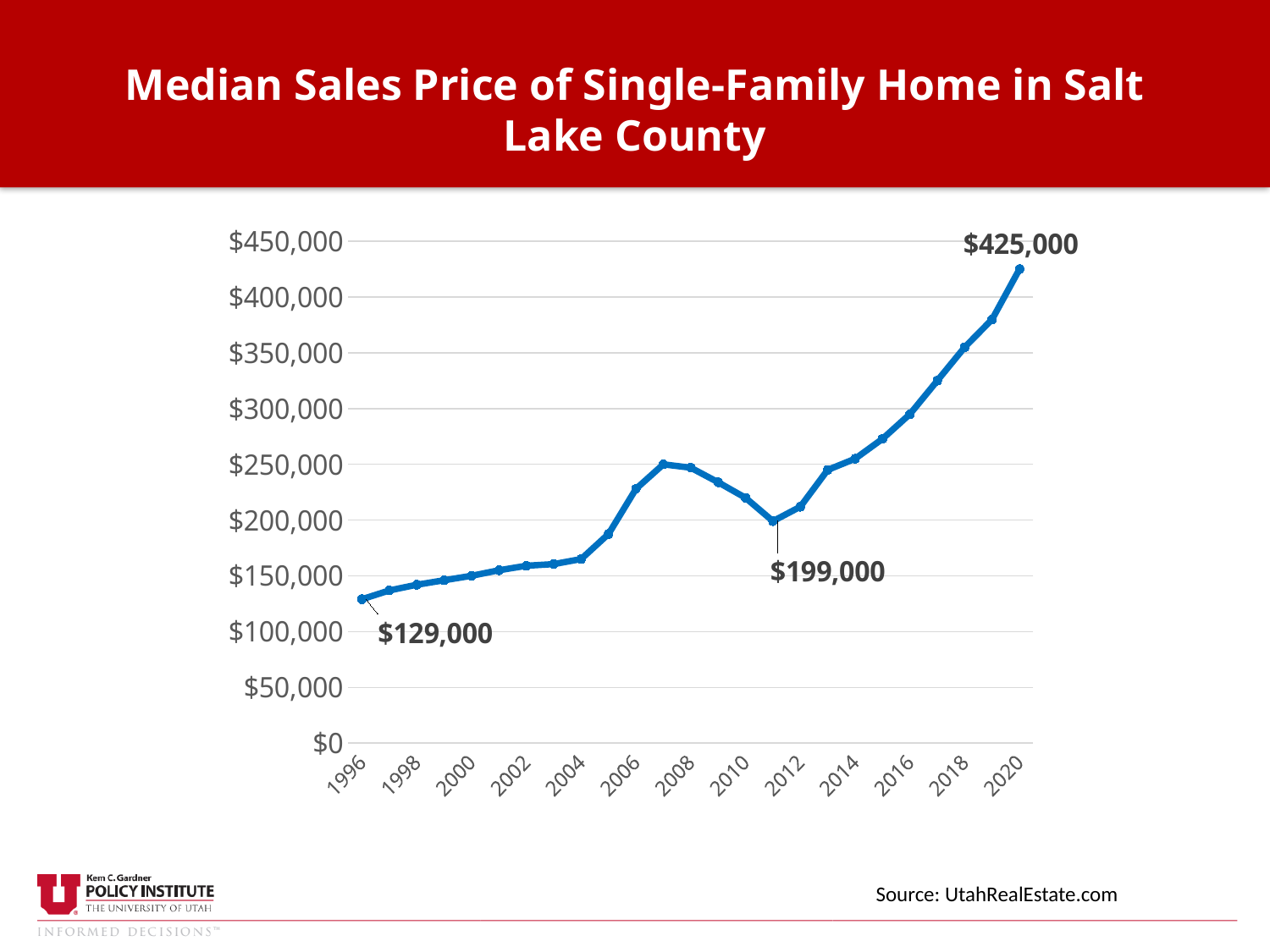
What was the median sales price of a single-family home in Salt Lake County in 1996? $129,000 What value is labeled at the low point of the dip around 2011? $199,000 Is the median sales price in 2002 greater or less than $200,000? less Which year has the highest median sales price on the chart? 2020 What is the difference between the $425,000 label and the $199,000 label? $226,000 Overall, does the median sales price rise or fall from 1996 to 2020? Rise Is the median sales price in 2006 greater or less than $200,000? greater What was the median sales price in 2020? $425,000 Which year has the lowest median sales price on the chart? 1996 How much higher is the 2020 median sales price than the 1996 median sales price? $296,000 What type of chart is shown on the slide? Line chart What is the title of the chart? Median Sales Price of Single-Family Home in Salt Lake County